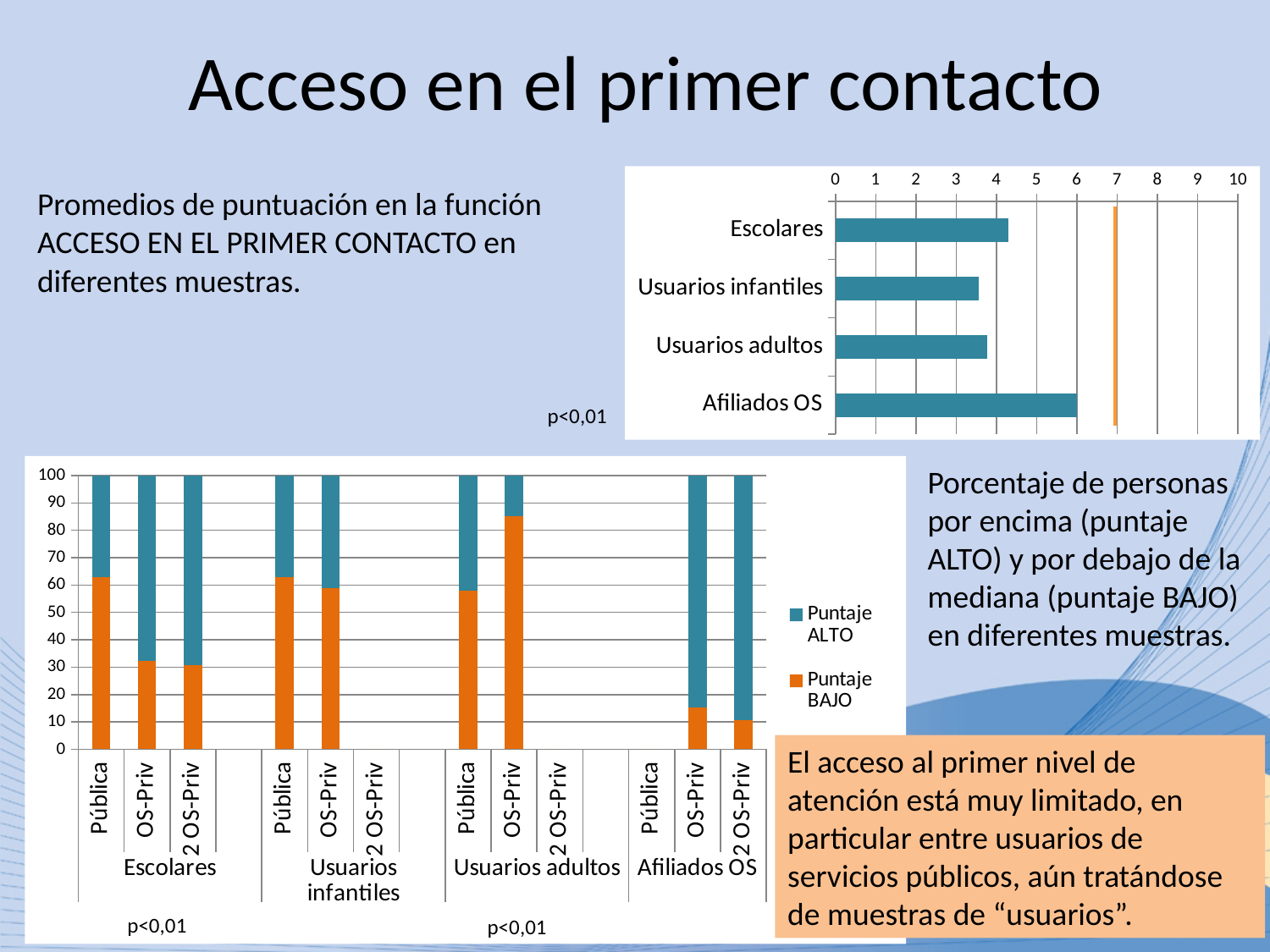
How many series does the legend of the bottom-left stacked bar chart list? 2 How many categories are shown in the top-right bar chart? 4 In the top-right bar chart, which category has the highest value? Afiliados OS In the bottom-left stacked bar chart, is the Puntaje BAJO value for Pública in the Escolares group greater or less than 50? greater In the top-right bar chart, which is larger, the value for Escolares or the value for Usuarios infantiles? Escolares In the top-right bar chart, is the value for Escolares greater or less than 5? less In the top-right bar chart, is the value for Afiliados OS greater or less than 5? greater What are the two series named in the legend of the bottom-left stacked bar chart? Puntaje ALTO and Puntaje BAJO In the bottom-left stacked bar chart, which has the larger Puntaje BAJO value, Pública or OS-Priv in the Usuarios adultos group? OS-Priv What kind of chart is the chart in the top right of the slide? bar chart